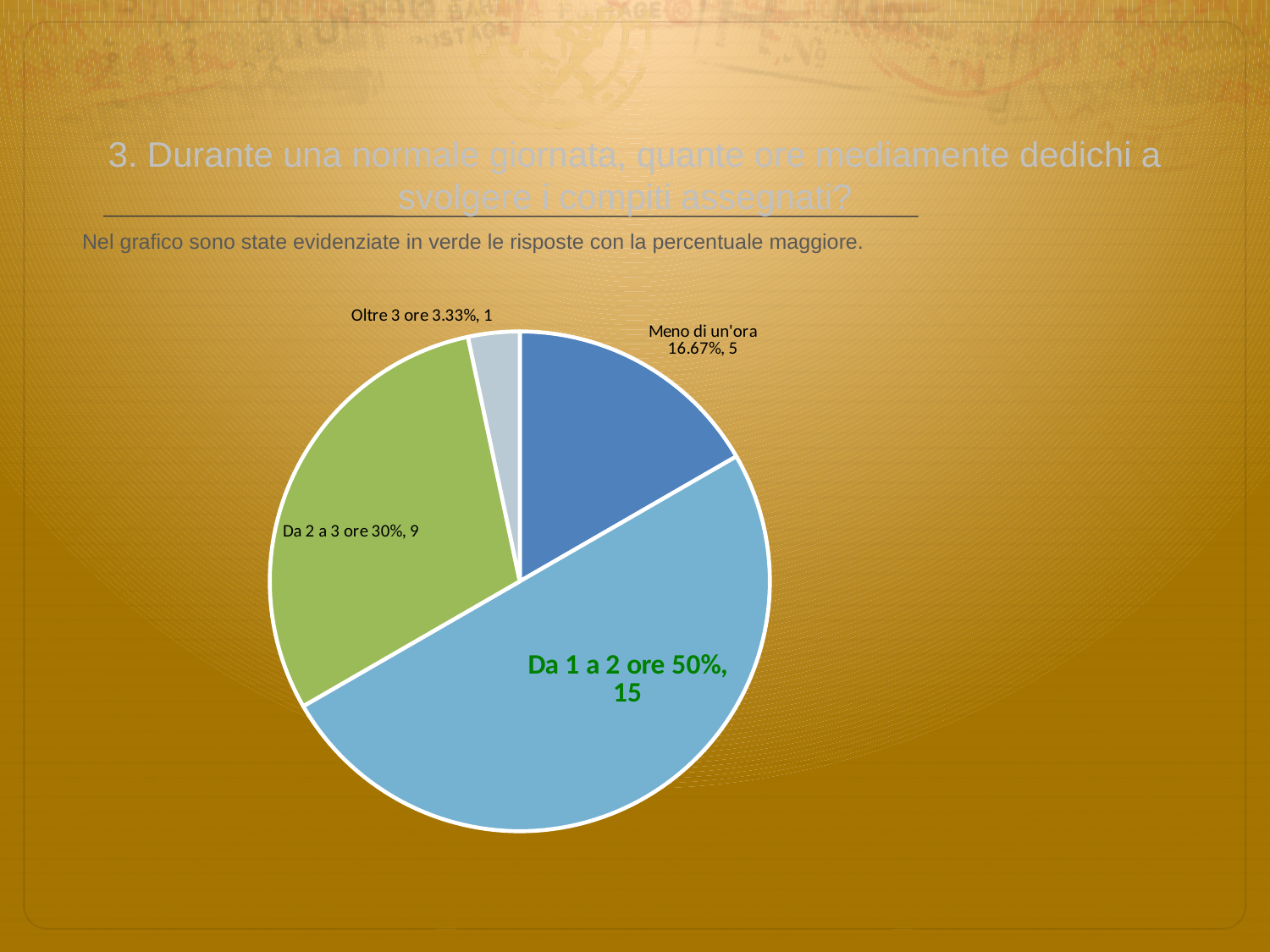
How many responses are shown for 'Da 2 a 3 ore'? 9 How many responses are shown for 'Oltre 3 ore'? 1 Which category has the largest share of the pie? Da 1 a 2 ore What percentage is shown for the 'Da 1 a 2 ore' slice? 50% Which slice's label is highlighted in green on the chart? Da 1 a 2 ore Which has more responses, 'Meno di un'ora' or 'Da 2 a 3 ore'? Da 2 a 3 ore What percentage is shown for 'Meno di un'ora'? 16.67% What is the difference in number of responses between 'Da 1 a 2 ore' and 'Da 2 a 3 ore'? 6 How many slices does the pie chart have? 4 What kind of chart is shown on the slide? pie chart What is the total number of responses across all slices? 30 Which category has the smallest share of the pie? Oltre 3 ore